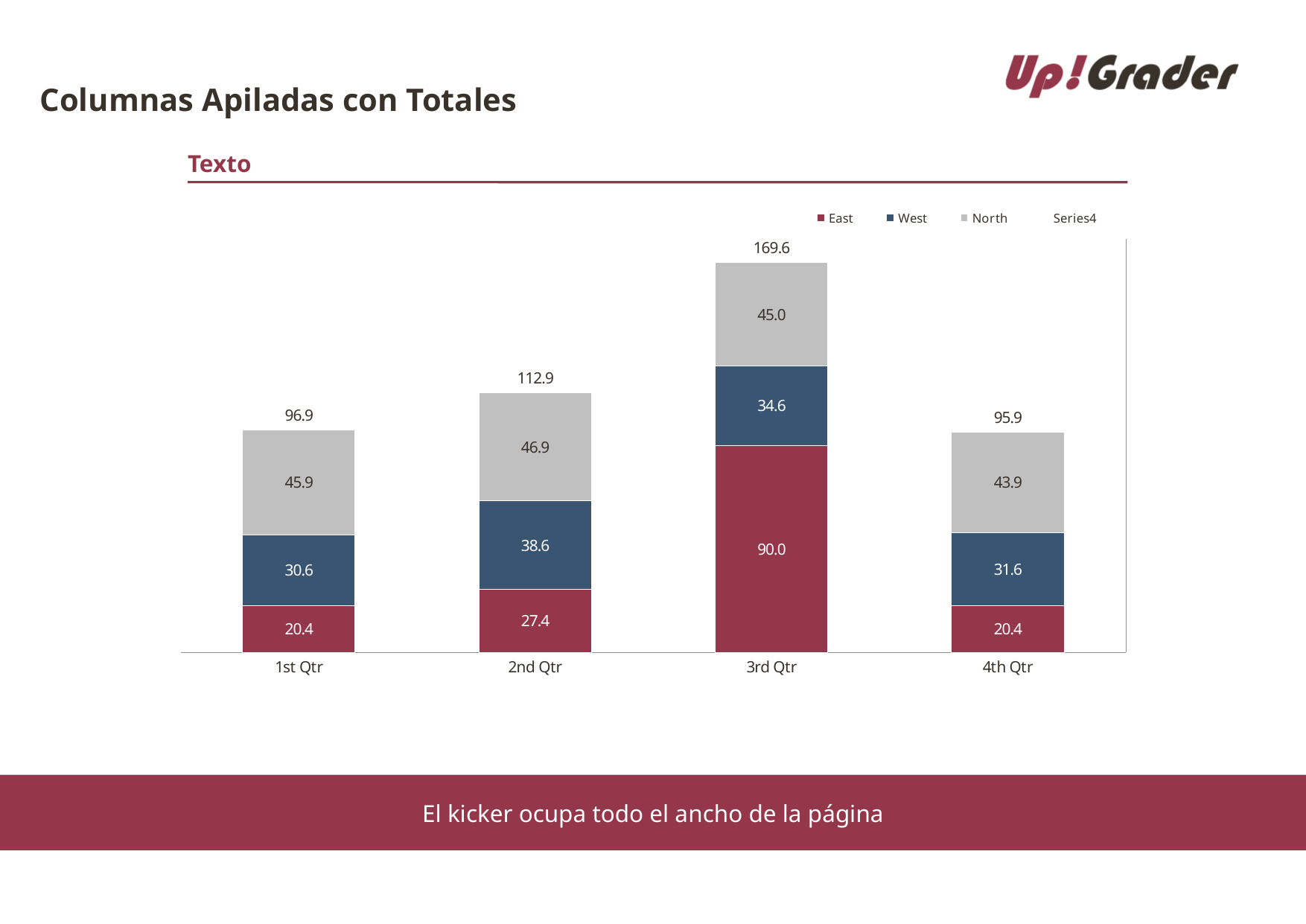
How many quarters are shown on the x axis? 4 Which colour represents the East series in the chart? Dark red Which is larger, the West value for 2nd Qtr or the West value for 1st Qtr? 2nd Qtr What is the difference between the East values for 3rd Qtr and 2nd Qtr? 62.6 What is the East value for 3rd Qtr? 90.0 What kind of chart is shown on the slide? Stacked bar chart How many series does the legend list? 4 Which quarter has the highest stacked total? 3rd Qtr What is the West value for 4th Qtr? 31.6 What is the total of the stacked bar for 2nd Qtr? 112.9 Which quarter has the lowest stacked total? 4th Qtr What is the North value for 2nd Qtr? 46.9